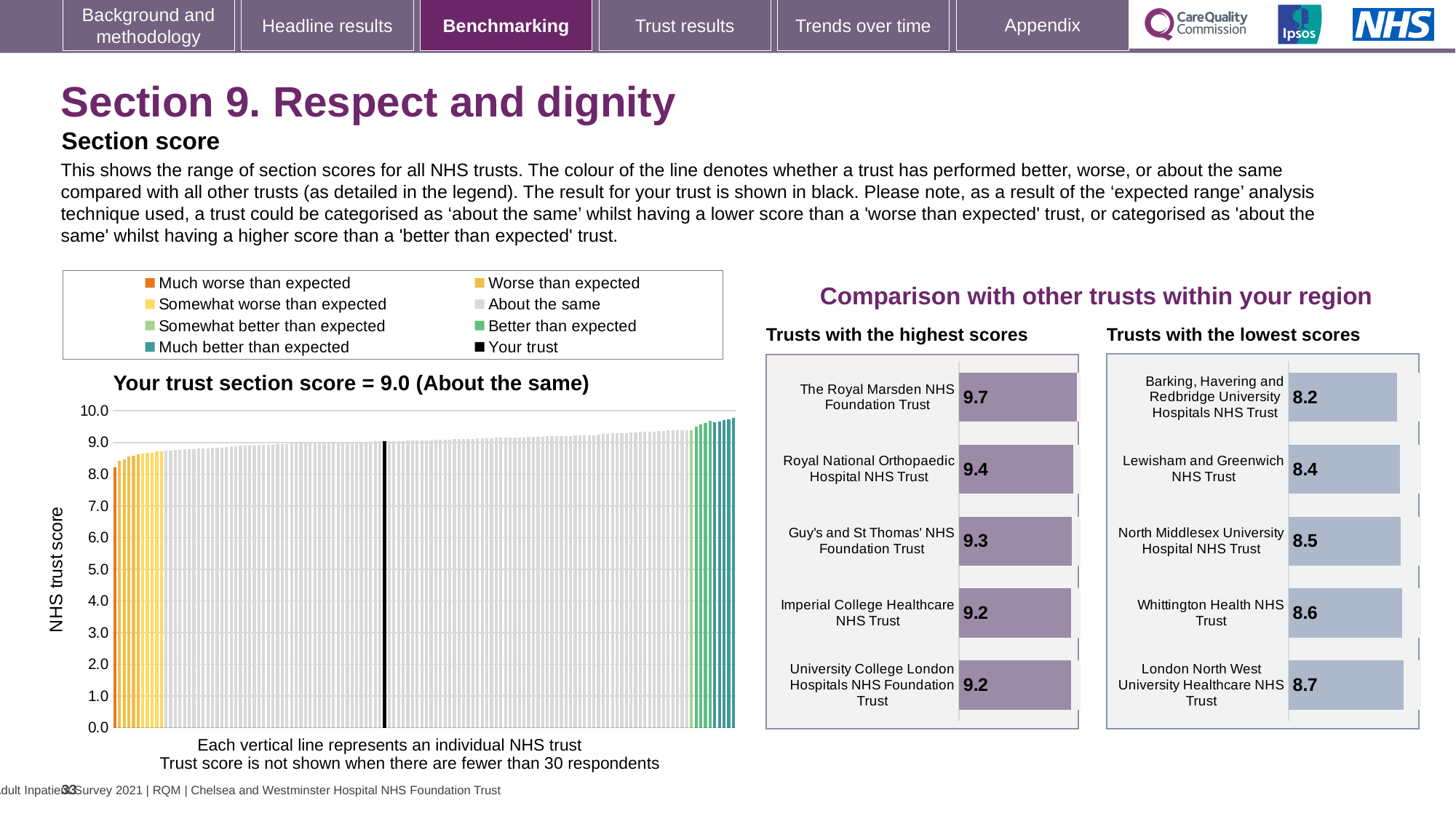
In the 'Trusts with the lowest scores' chart, which has the larger score: North Middlesex University Hospital NHS Trust or Whittington Health NHS Trust? Whittington Health NHS Trust In the 'Trusts with the lowest scores' chart, what is the difference between the scores of London North West University Healthcare NHS Trust and Barking, Havering and Redbridge University Hospitals NHS Trust? 0.5 How many entries does the legend of the main chart on the left list? 8 In the 'Trusts with the lowest scores' chart, what is the score for Lewisham and Greenwich NHS Trust? 8.4 In the 'Trusts with the highest scores' chart, which trust has the highest score? The Royal Marsden NHS Foundation Trust How many trusts are shown in the 'Trusts with the lowest scores' chart? 5 In the 'Trusts with the highest scores' chart, what is the score for The Royal Marsden NHS Foundation Trust? 9.7 What is the label on the vertical axis of the main chart on the left? NHS trust score According to the title of the main chart on the left, what is your trust's section score? 9.0 In the 'Trusts with the lowest scores' chart, which trust has the lowest score? Barking, Havering and Redbridge University Hospitals NHS Trust What kind of chart is the 'Trusts with the highest scores' chart? Bar chart In the 'Trusts with the highest scores' chart, what is the difference between the scores of The Royal Marsden NHS Foundation Trust and Imperial College Healthcare NHS Trust? 0.5